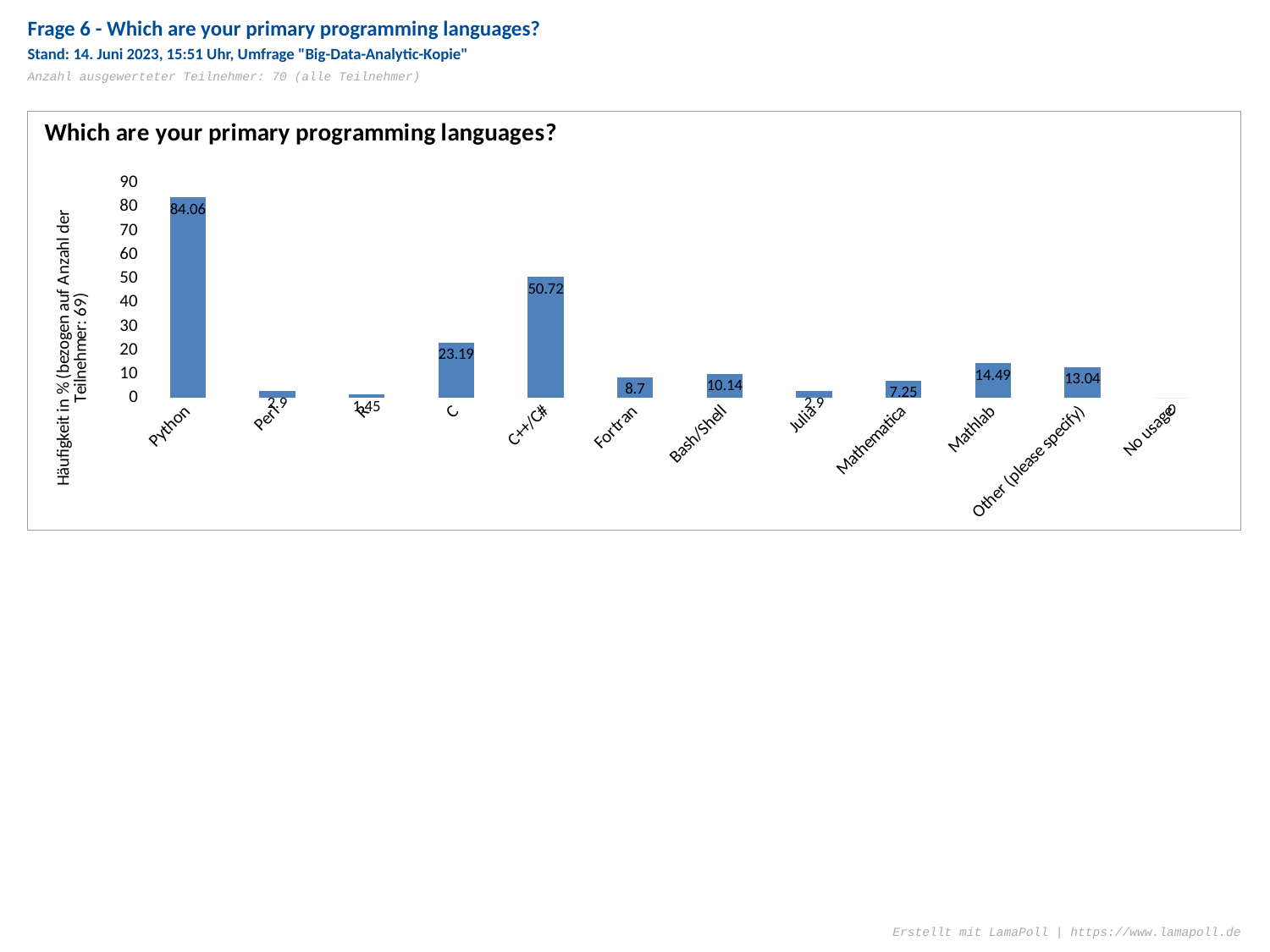
What is the title of the chart? Which are your primary programming languages? What is the difference between the values for Python and C++/C#? 33.34 What kind of chart is shown on the slide? bar chart What is the value for Bash/Shell? 10.14 Is the value for Fortran greater or less than 10? less How many categories are shown on the x axis? 12 What is the value for C? 23.19 What is the value for C++/C#? 50.72 What is the value for Python? 84.06 Which programming language has the highest value? Python Which has a larger value, Mathlab or Other (please specify)? Mathlab Which category has the lowest value? No usage